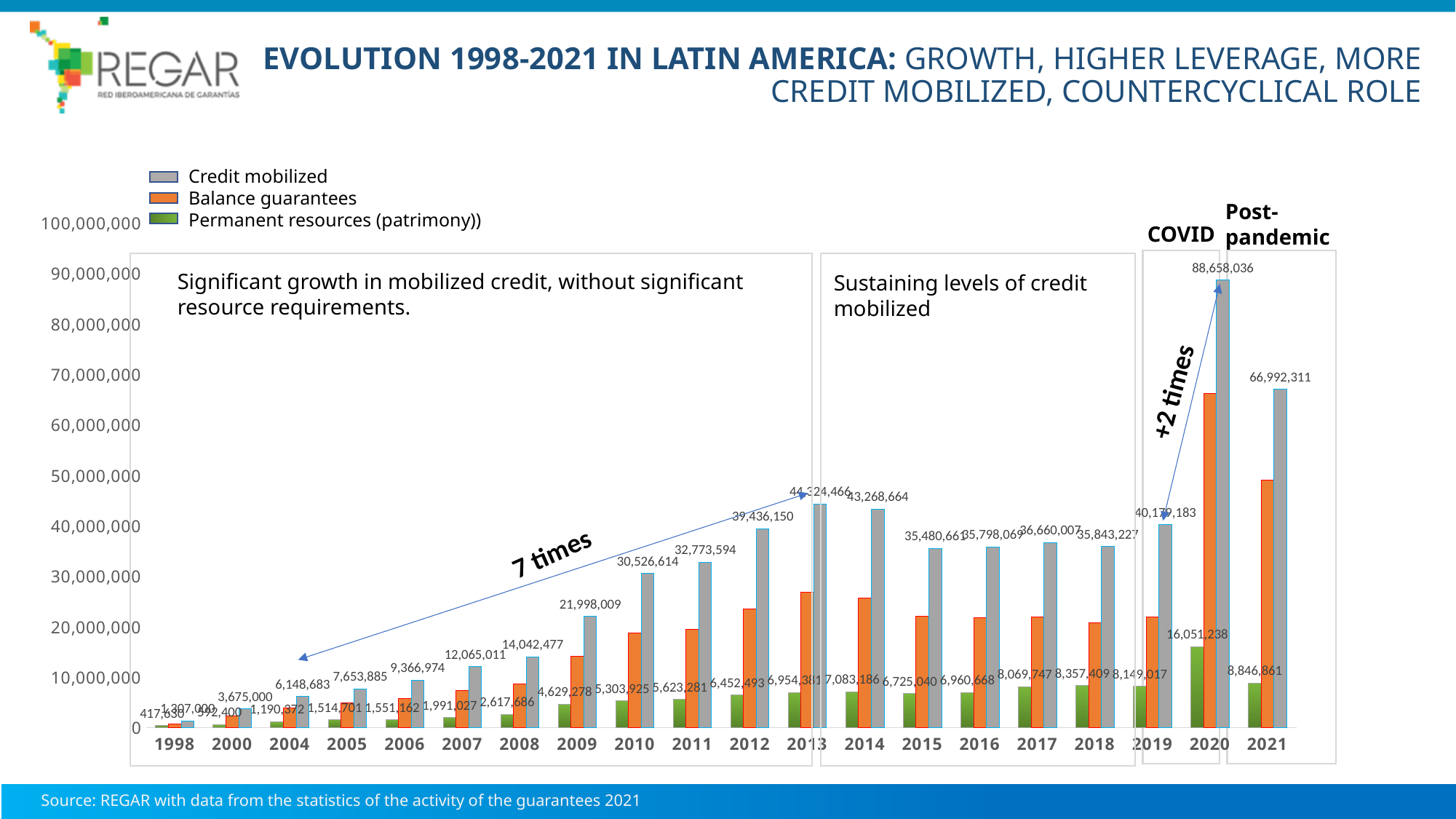
What type of chart is shown on the slide? Bar chart What is the value of Credit mobilized in 2020? 88,658,036 In which year is Credit mobilized lowest? 1998 What is the value of Credit mobilized in 2021? 66,992,311 How many years are shown on the x axis? 20 In which year is Credit mobilized highest? 2020 What is the difference between Credit mobilized in 2020 and in 2021? 21,665,725 Is the value for Balance guarantees in 2020 greater or less than 60,000,000? greater What is the value of Credit mobilized in 2012? 39,436,150 How many series does the legend list? 3 What is the value of Permanent resources (patrimony) in 2020? 16,051,238 Which is larger, Credit mobilized in 2012 or in 2014? 2014